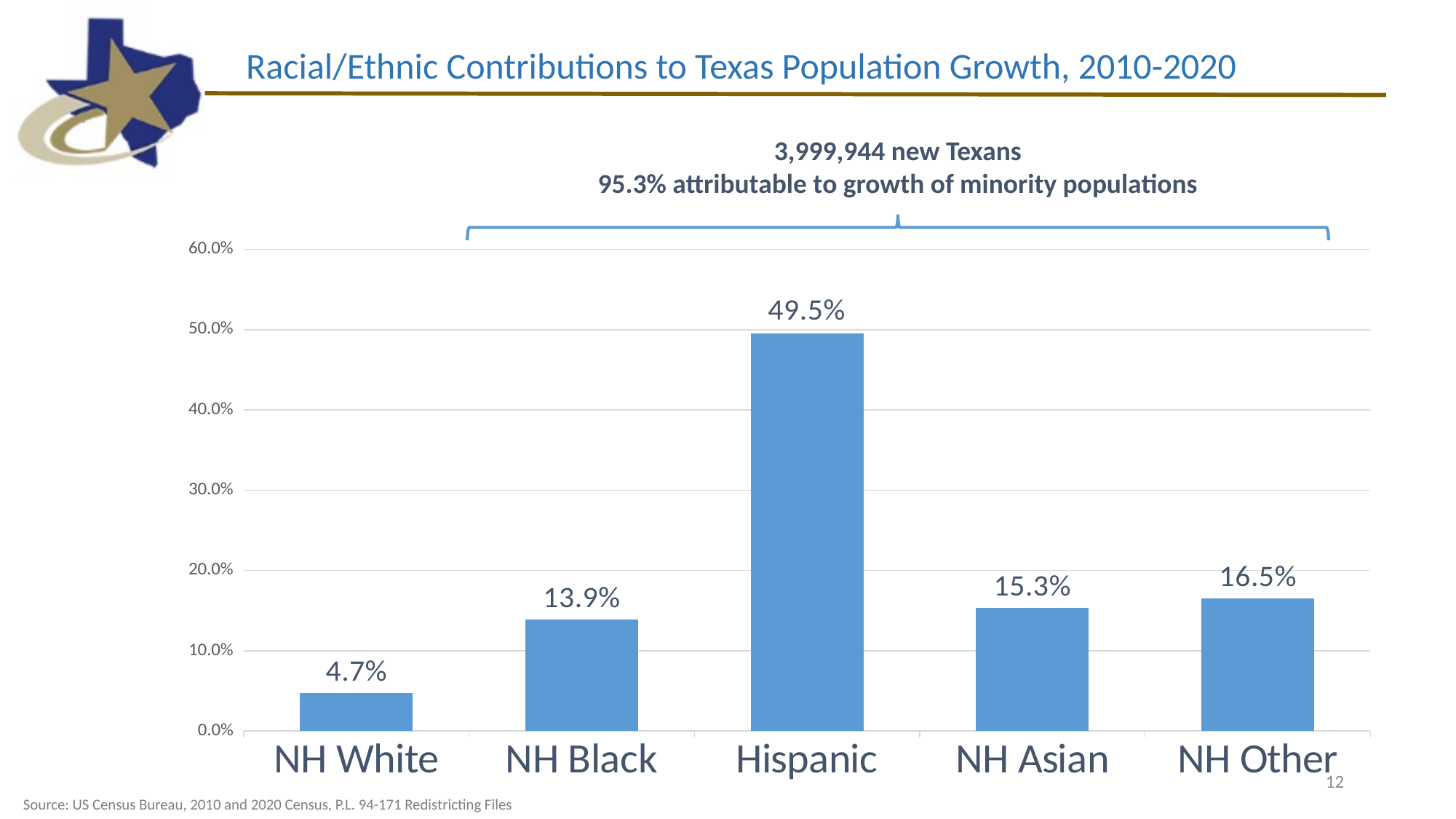
What kind of chart is shown on the slide? Bar chart Which category has the lowest value? NH White What is the difference between the values for Hispanic and NH Black? 35.6% What is the value for NH Other? 16.5% How many categories are shown on the x axis? 5 What is the title of the chart? Racial/Ethnic Contributions to Texas Population Growth, 2010-2020 What is the difference between the values for NH Other and NH White? 11.8% Which category has the highest value? Hispanic What is the value for Hispanic? 49.5% What is the value for NH White? 4.7% What is the value for NH Asian? 15.3% Which is larger, the value for NH Black or the value for NH Asian? NH Asian